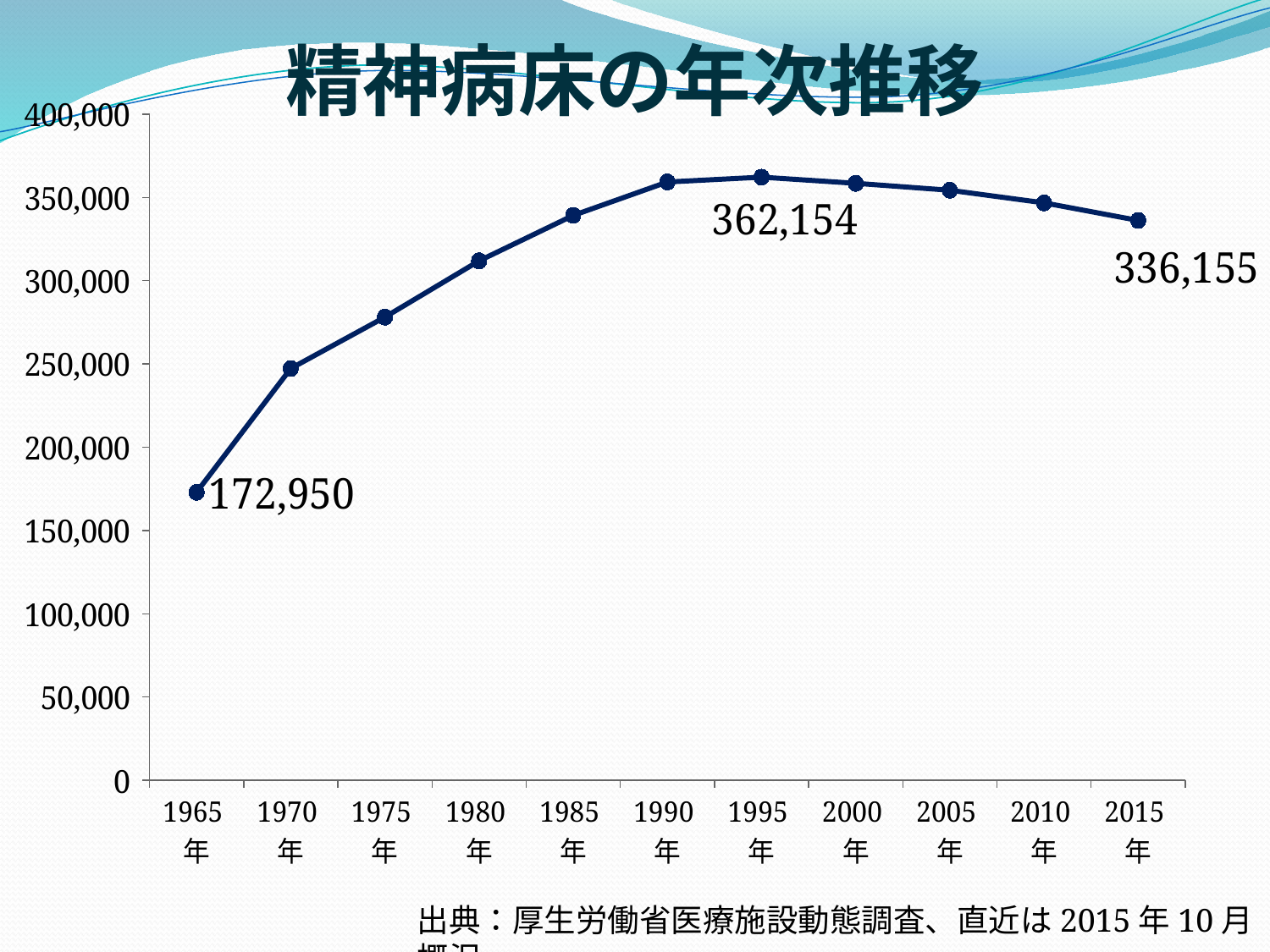
Which is larger, the value for 1965年 or the value for 2015年? 2015年 What is the value for 2015年? 336,155 Which year has the lowest value? 1965年 What is the difference between the values for 1995年 and 2015年? 25,999 What is the value for 1995年? 362,154 Is the value for 1985年 greater or less than 350,000? less What kind of chart is shown on the slide? line chart What is the difference between the values for 1995年 and 1965年? 189,204 What is the value for 1965年? 172,950 How many data points are plotted on the chart? 11 Is the value for 1980年 greater or less than 300,000? greater Do the values rise or fall from 1965年 to 1995年? rise